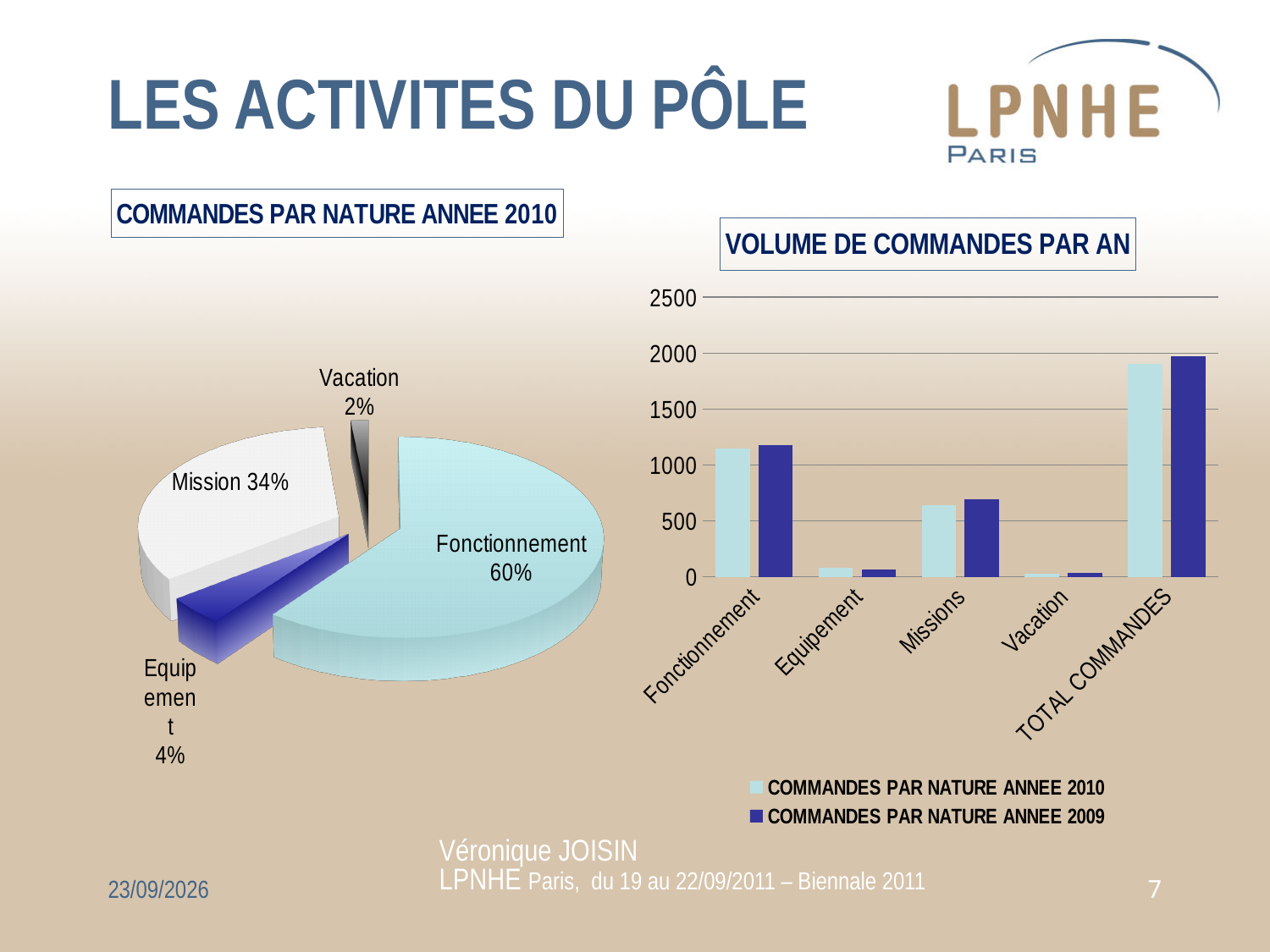
What kind of chart is VOLUME DE COMMANDES PAR AN? Bar chart In the pie chart COMMANDES PAR NATURE ANNEE 2010, what is the value for Vacation? 2% In the chart VOLUME DE COMMANDES PAR AN, which category has the lowest bars? Vacation In the pie chart COMMANDES PAR NATURE ANNEE 2010, which category has the largest slice? Fonctionnement In the pie chart COMMANDES PAR NATURE ANNEE 2010, what share does Fonctionnement have? 60% In the chart VOLUME DE COMMANDES PAR AN, is the value for Fonctionnement in COMMANDES PAR NATURE ANNEE 2010 greater or less than 1000? greater In the pie chart COMMANDES PAR NATURE ANNEE 2010, which category has the smallest slice? Vacation In the pie chart COMMANDES PAR NATURE ANNEE 2010, what is the value for Mission? 34% In the pie chart COMMANDES PAR NATURE ANNEE 2010, how many slices are there? 4 In the pie chart COMMANDES PAR NATURE ANNEE 2010, how many percentage points larger is Fonctionnement than Mission? 26 In the chart VOLUME DE COMMANDES PAR AN, how many series does the legend list? 2